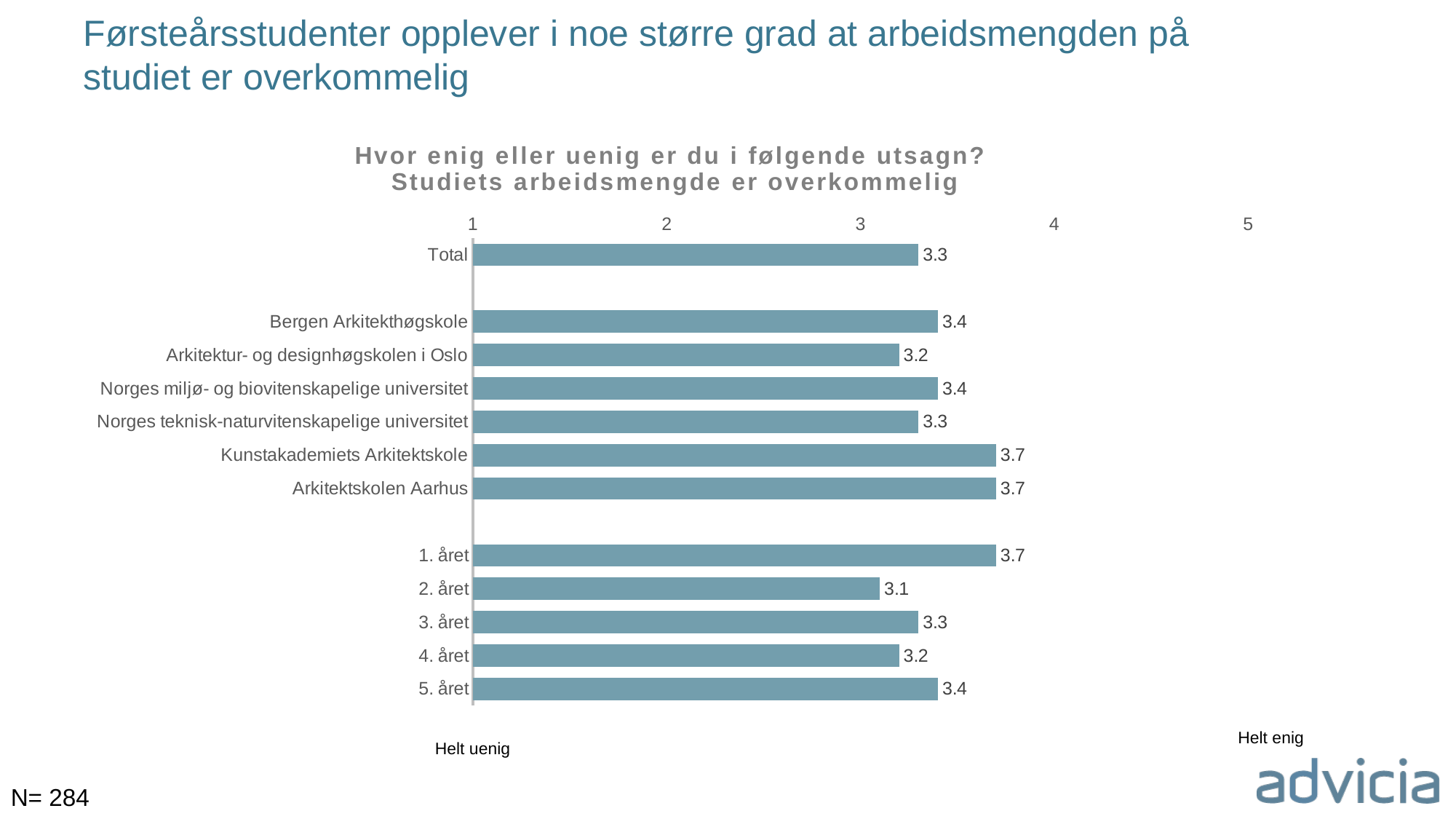
What is the value for Arkitektur- og designhøgskolen i Oslo? 3.2 What is the value for Total? 3.3 What is the value for Kunstakademiets Arkitektskole? 3.7 Which is larger, the value for Bergen Arkitekthøgskole or the value for Norges teknisk-naturvitenskapelige universitet? Bergen Arkitekthøgskole What is the value for 2. året? 3.1 What is the difference between the values for 1. året and 2. året? 0.6 What is the value for 5. året? 3.4 Which category has the lowest value? 2. året Is the value for Arkitektskolen Aarhus greater or less than 4? less What label appears at the left end of the scale below the chart? Helt uenig How many bars are plotted in the chart? 12 What kind of chart is shown on the slide? bar chart